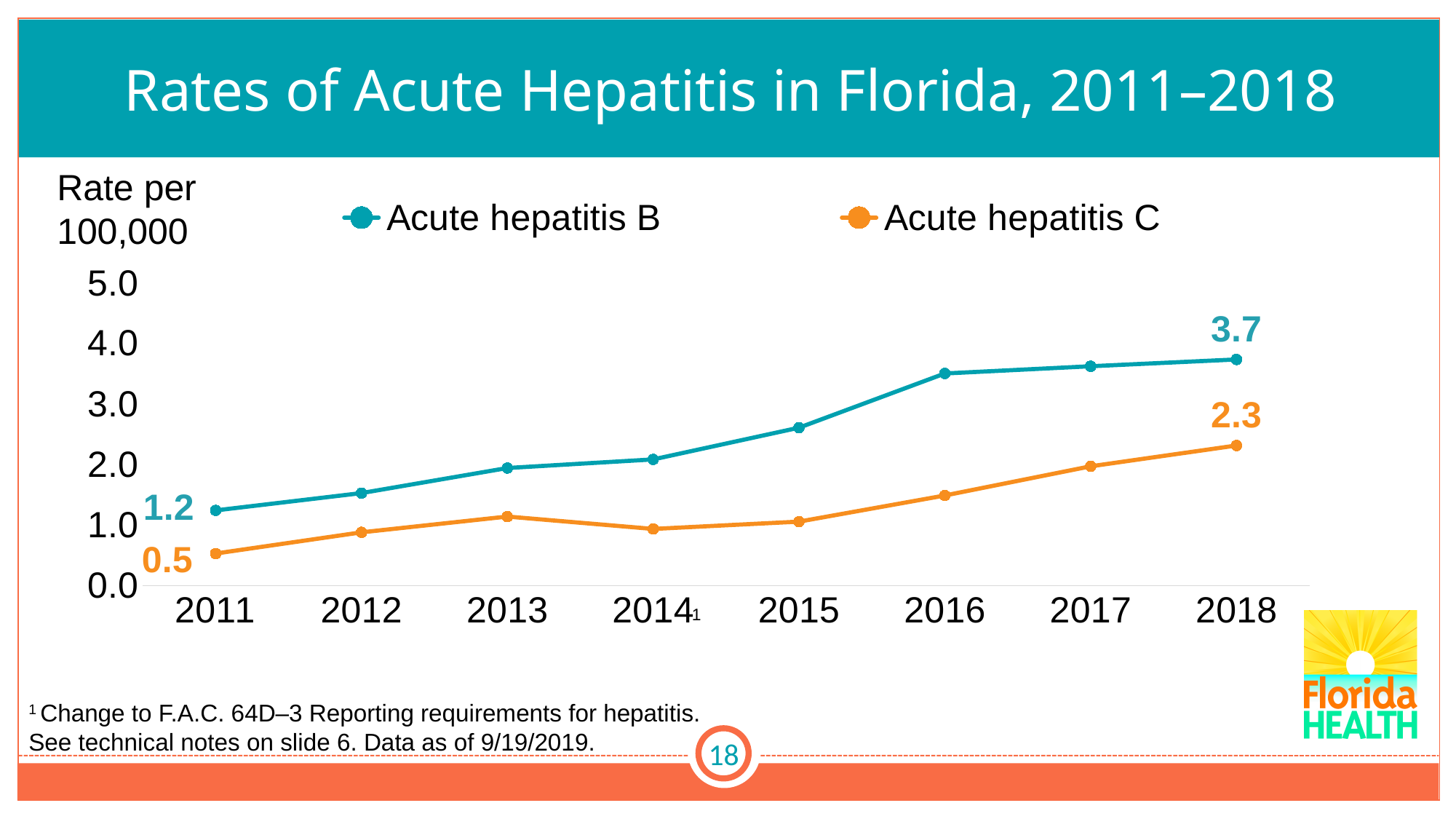
How many years are shown on the x axis? 8 What is the difference between the acute hepatitis B and acute hepatitis C rates in 2018? 1.4 What kind of chart is shown on the slide? Line chart What is the rate of acute hepatitis C in 2011? 0.5 Which series has the higher rate in 2016, acute hepatitis B or acute hepatitis C? Acute hepatitis B What is the rate of acute hepatitis C in 2018? 2.3 What is the rate of acute hepatitis B in 2018? 3.7 By how much did the acute hepatitis B rate increase from 2011 to 2018? 2.5 What is the rate of acute hepatitis B in 2011? 1.2 Is the acute hepatitis B rate in 2015 greater or less than 2.0? greater How many series does the legend list? 2